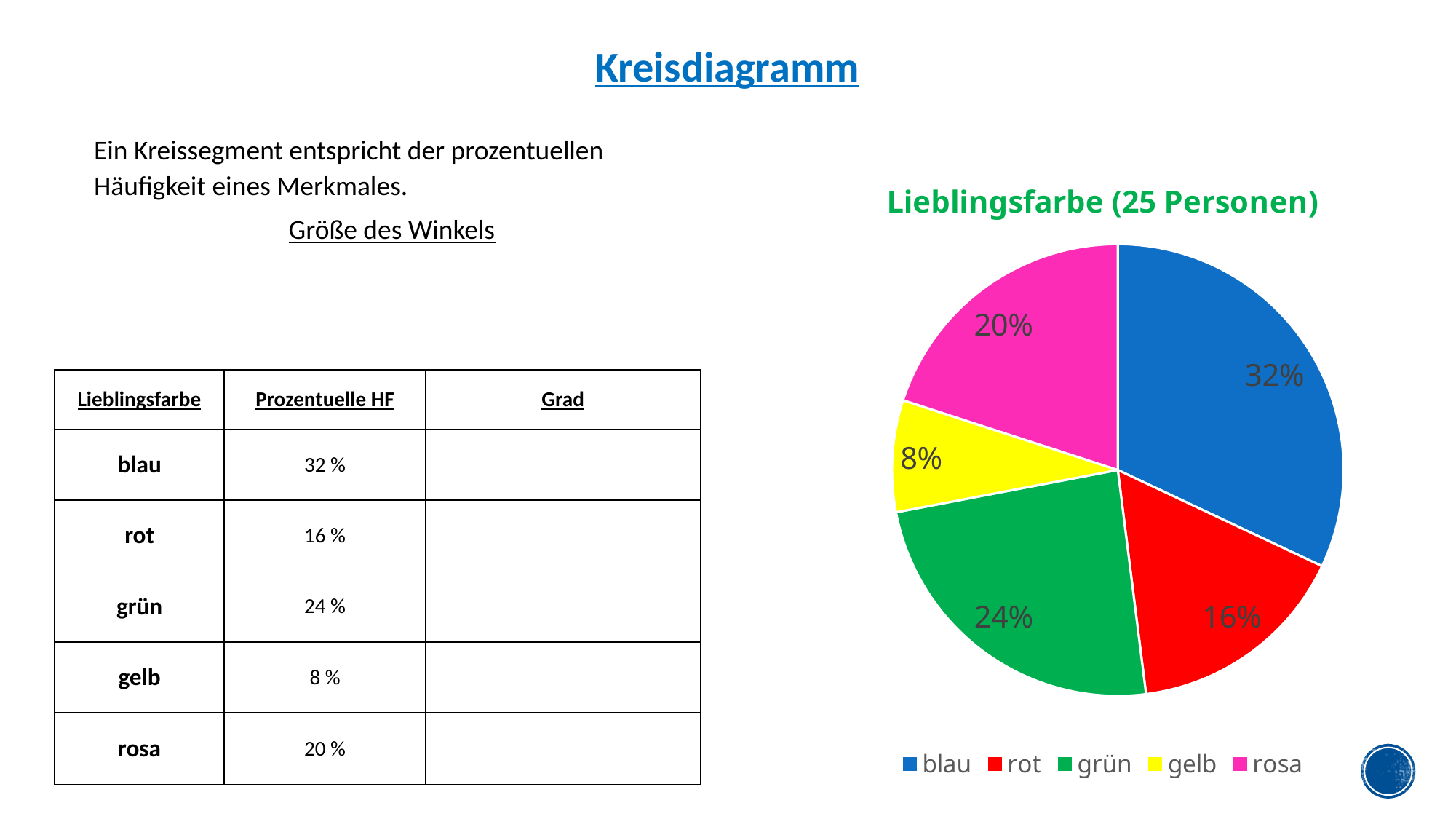
Which slice is larger, grün or rosa? grün What share of the pie does the rosa slice represent? 20% What share of the pie does the grün slice represent? 24% Which colour has the largest slice in the pie chart? blau What is the difference in percentage points between the blau and rot slices? 16 What is the title of the pie chart? Lieblingsfarbe (25 Personen) What kind of chart is shown on the slide? pie chart How many slices does the pie chart have? 5 Which colour is used for the rosa slice in the pie chart? pink/magenta What share of the pie does the blau slice represent? 32% Which colour has the smallest slice in the pie chart? gelb